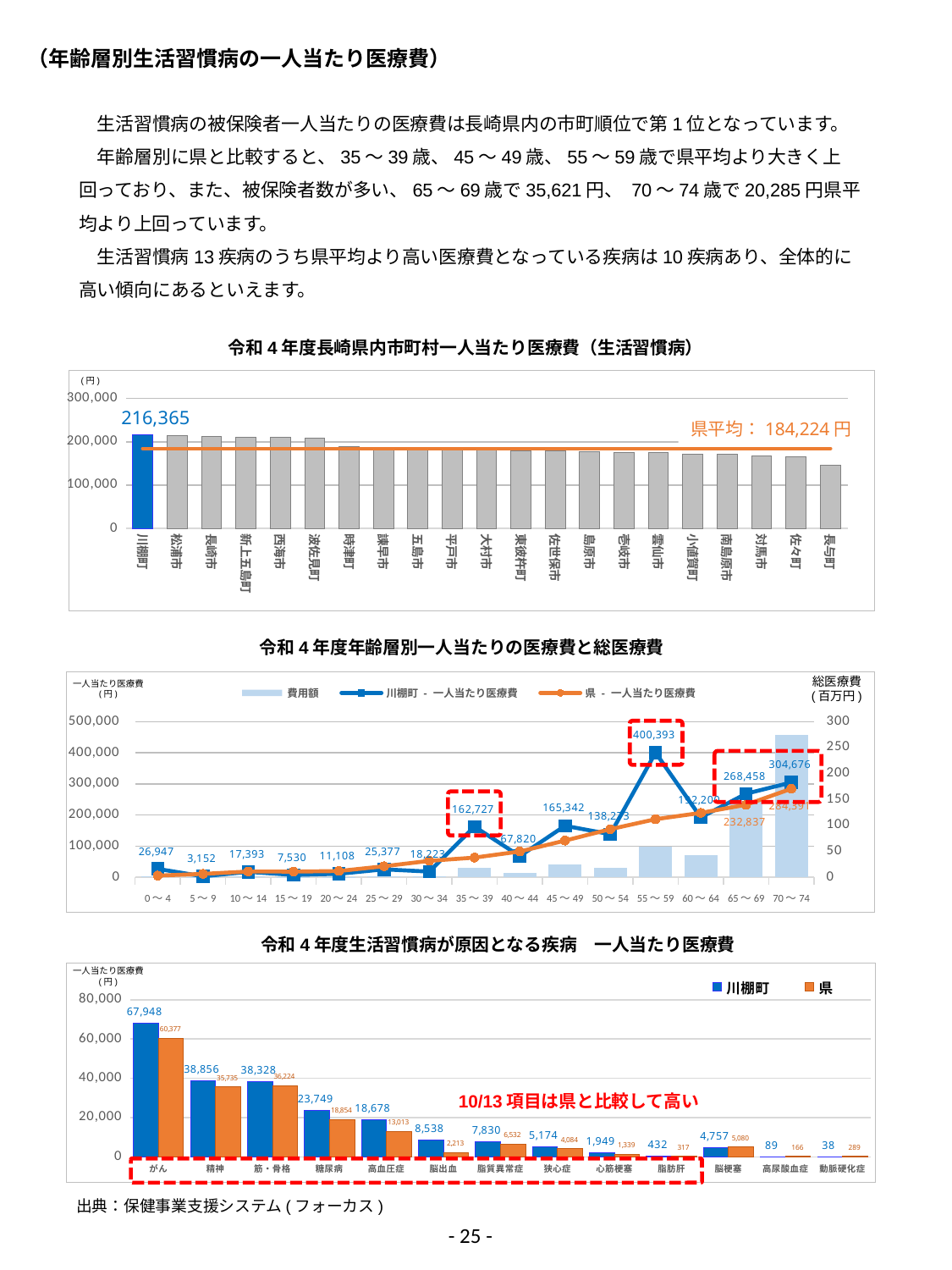
In the middle chart (令和4年度年齢層別一人当たりの医療費と総医療費), how many age groups are shown on the x axis? 15 In the middle chart (令和4年度年齢層別一人当たりの医療費と総医療費), what is the 川棚町 value for the 55～59 age group? 400,393 In the bottom chart (令和4年度生活習慣病が原因となる疾病 一人当たり医療費), what is the difference between the 川棚町 and 県 values for 脳出血? 6,325 In the bottom chart (令和4年度生活習慣病が原因となる疾病 一人当たり医療費), how many diseases are shown on the x axis? 13 In the middle chart (令和4年度年齢層別一人当たりの医療費と総医療費), what is the 川棚町 value for the 35～39 age group? 162,727 In the bottom chart (令和4年度生活習慣病が原因となる疾病 一人当たり医療費), which is larger for 脳梗塞, 川棚町 or 県? 県 In the bottom chart (令和4年度生活習慣病が原因となる疾病 一人当たり医療費), what is the 川棚町 value for がん? 67,948 In the top chart (令和4年度長崎県内市町村一人当たり医療費), what is the value for 川棚町? 216,365 In the top chart (令和4年度長崎県内市町村一人当たり医療費), how many municipalities are shown? 21 In the top chart (令和4年度長崎県内市町村一人当たり医療費), what is the 県平均 shown? 184,224円 In the middle chart (令和4年度年齢層別一人当たりの医療費と総医療費), how many series does the legend list? 3 In the top chart (令和4年度長崎県内市町村一人当たり医療費), which municipality has the highest value? 川棚町